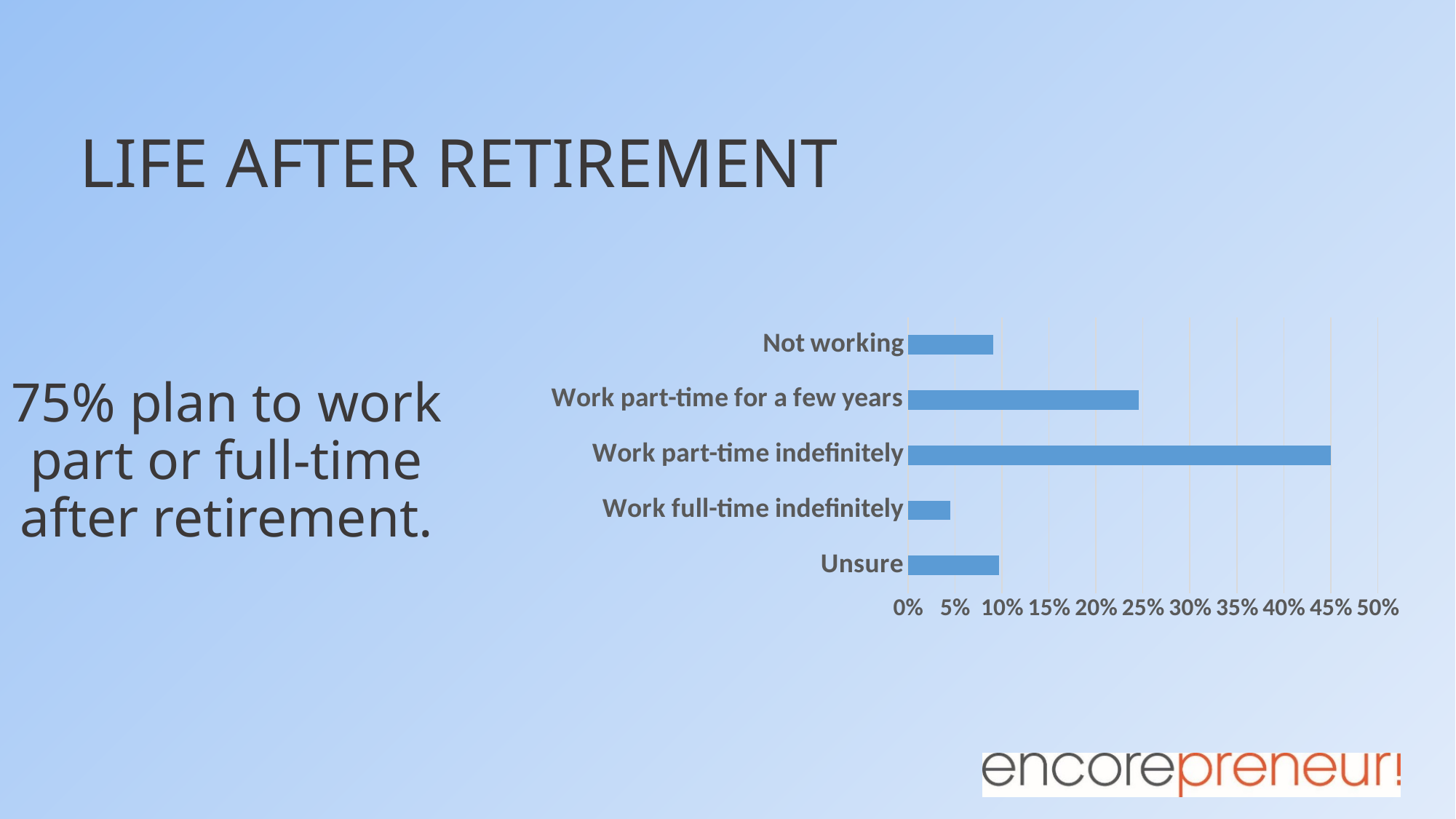
Is the value for Not working greater or less than 10%? less Is the value for Work full-time indefinitely greater or less than 10%? less What is the highest value shown on the chart's percentage axis? 50% Is the value for Work part-time for a few years greater or less than 20%? greater Which is larger, the value for Work part-time for a few years or the value for Not working? Work part-time for a few years How many categories does the chart show? 5 Which is larger, the value for Work part-time indefinitely or the value for Work part-time for a few years? Work part-time indefinitely Which category has the highest value? Work part-time indefinitely Which category has the lowest value? Work full-time indefinitely What kind of chart is shown on the slide? bar chart